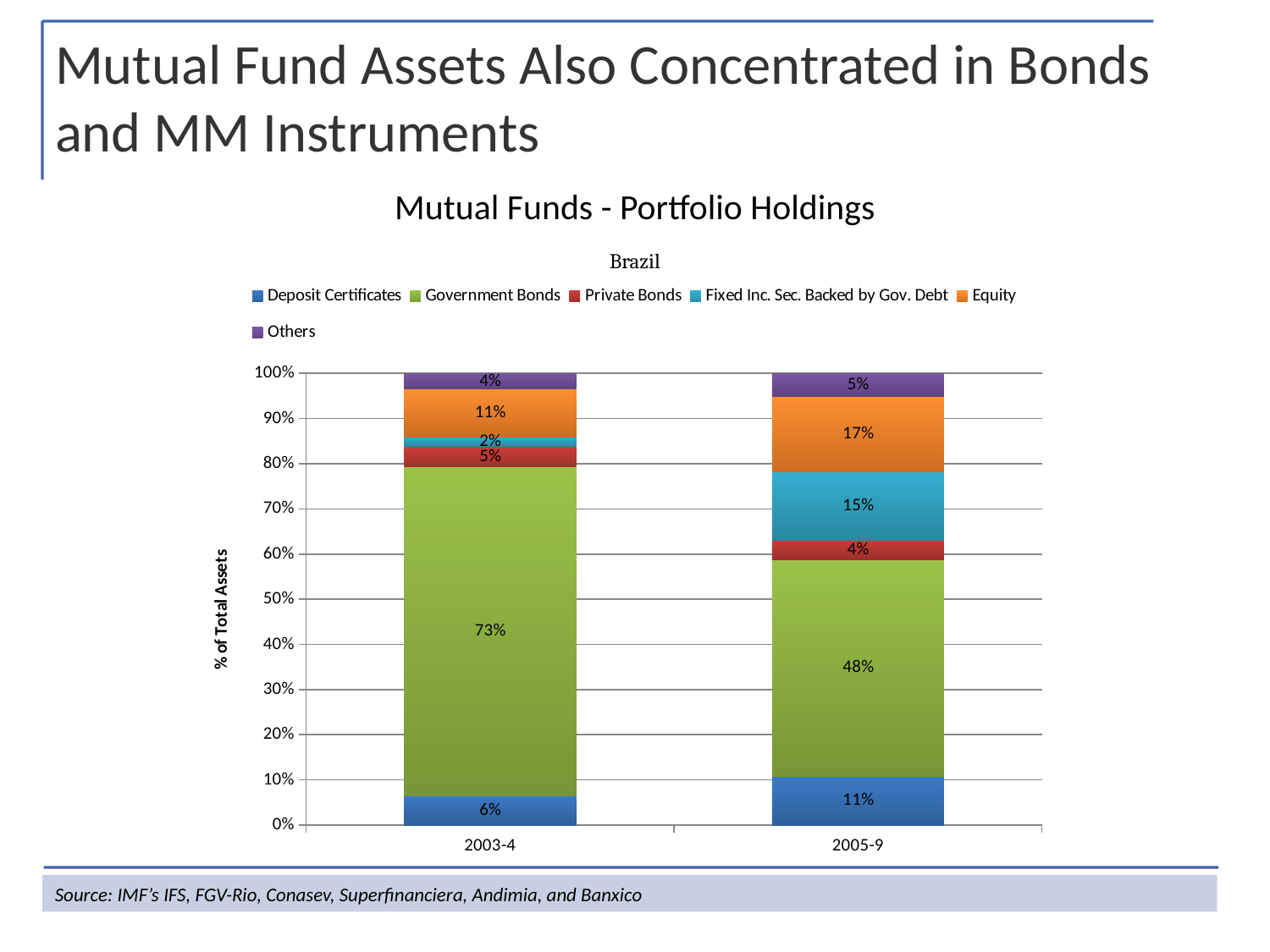
Which holding category has the smallest share in the 2005-9 bar? Private Bonds What percentage of total assets did Government Bonds make up in 2003-4? 73% What is the Equity share of mutual fund portfolio holdings in 2005-9? 17% What is the label on the vertical axis of the chart? % of Total Assets What share did Deposit Certificates hold in 2003-4? 6% How many time periods are shown on the x axis? 2 By how many percentage points did the Government Bonds share fall from 2003-4 to 2005-9? 25 percentage points Which holding category has the largest share in the 2003-4 bar? Government Bonds What kind of chart is shown on the slide? Stacked bar chart Which period has the larger Equity share, 2003-4 or 2005-9? 2005-9 How many series does the legend list? 6 What is the value for Fixed Inc. Sec. Backed by Gov. Debt in 2005-9? 15%